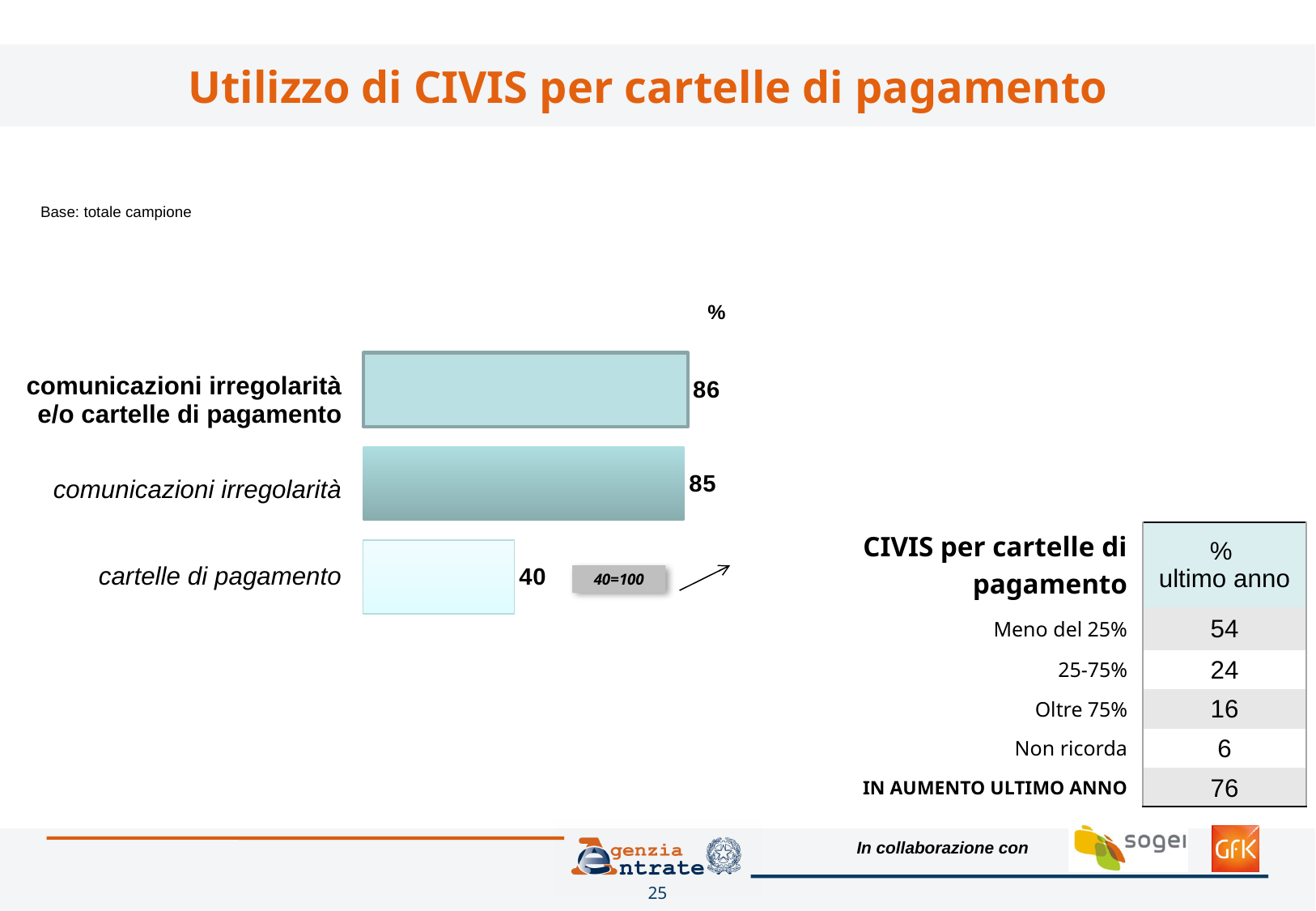
What does the label in the grey box next to the "cartelle di pagamento" bar say? 40=100 What is the value for "comunicazioni irregolarità e/o cartelle di pagamento" in the bar chart? 86 Which category has the lowest value in the bar chart? cartelle di pagamento What kind of chart is shown on the slide? bar chart What is the difference between the values for "comunicazioni irregolarità" and "cartelle di pagamento"? 45 What is the difference between the values for "comunicazioni irregolarità e/o cartelle di pagamento" and "comunicazioni irregolarità"? 1 How many categories are shown in the bar chart? 3 What is the value for "comunicazioni irregolarità" in the bar chart? 85 What unit is indicated above the bar chart's data labels? % Which is larger: the value for "comunicazioni irregolarità" or the value for "cartelle di pagamento"? comunicazioni irregolarità What is the value for "cartelle di pagamento" in the bar chart? 40 Which category has the highest value in the bar chart? comunicazioni irregolarità e/o cartelle di pagamento